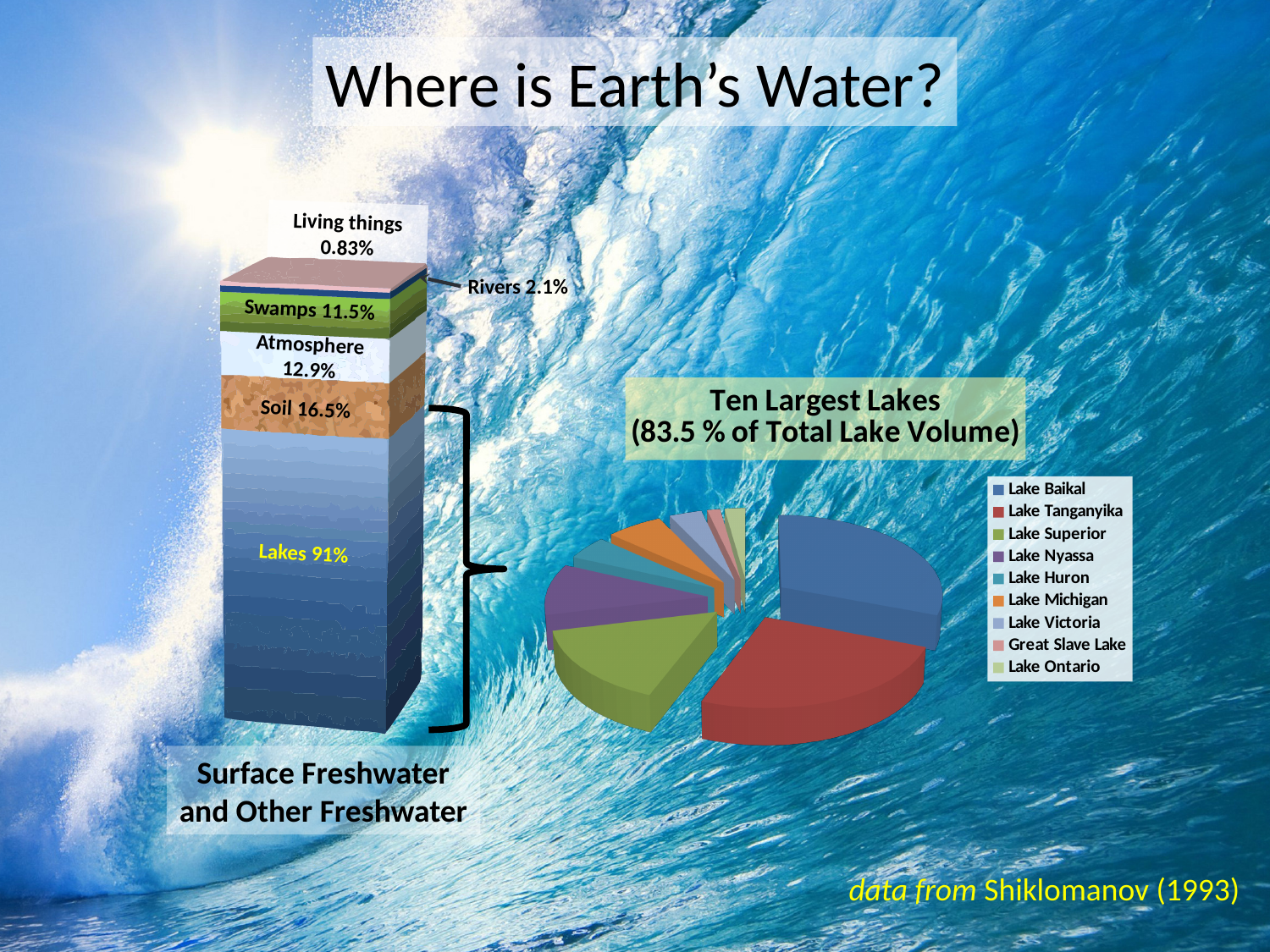
In the stacked bar chart on the left, which segment has the smallest percentage? Living things In the stacked bar chart on the left, what percentage is shown for Atmosphere? 12.9% In the stacked bar chart on the left, which segment has the largest percentage? Lakes In the stacked bar chart on the left, what percentage is shown for Soil? 16.5% How many lakes are listed in the legend of the pie chart on the right? 9 How many labelled segments does the stacked bar chart on the left have? 6 In the stacked bar chart on the left, what percentage is shown for Rivers? 2.1% In the stacked bar chart on the left, which is larger, Swamps or Atmosphere? Atmosphere In the stacked bar chart on the left, what percentage is shown for Lakes? 91% In the stacked bar chart on the left, what percentage is shown for Living things? 0.83% In the pie chart on the right, which slice is larger, Lake Superior or Lake Nyassa? Lake Superior In the stacked bar chart on the left, what is the difference between the Soil and Atmosphere percentages? 3.6%